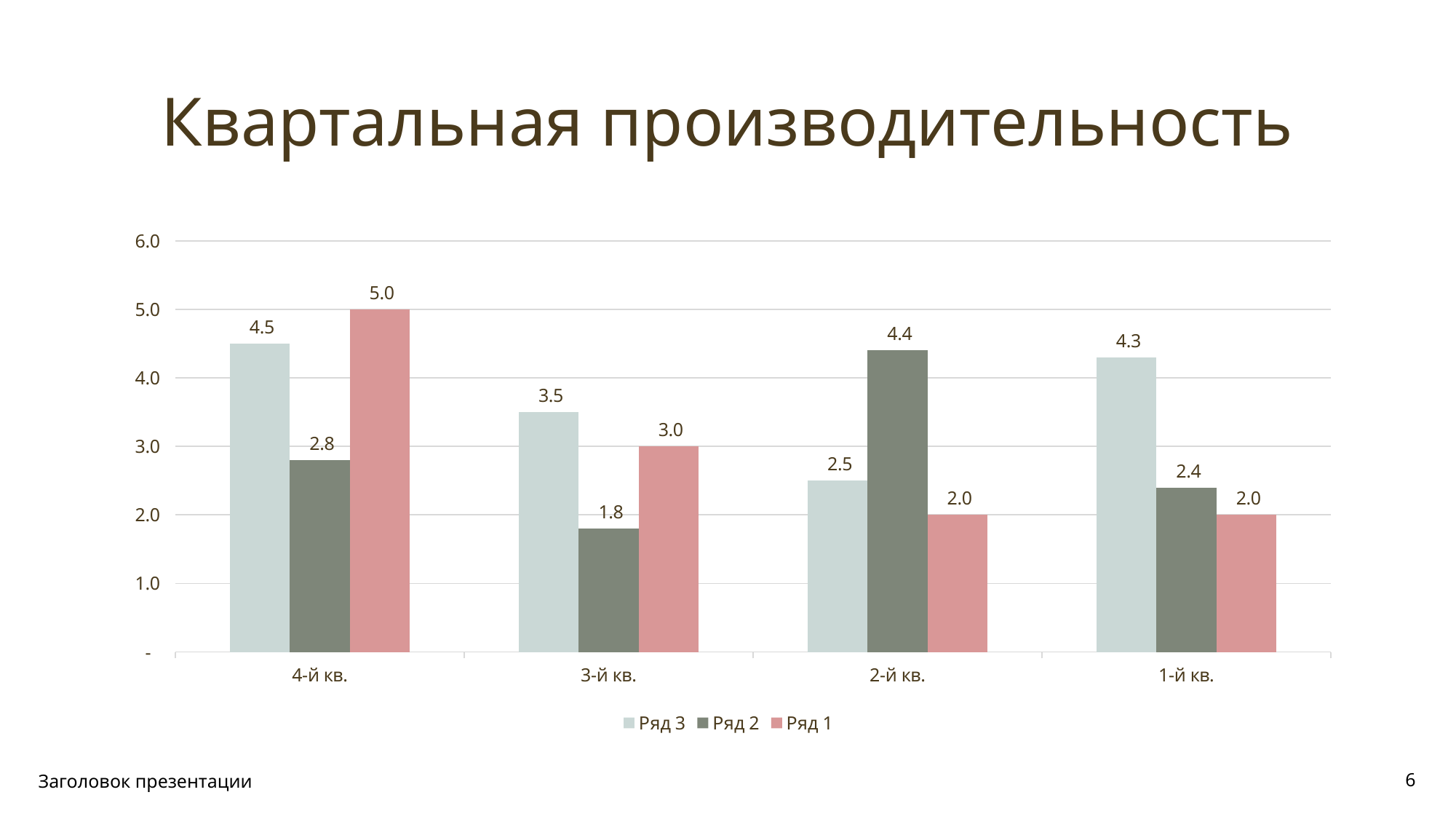
Which series is shown in pink? Ряд 1 What is the value of Ряд 1 for 4-й кв.? 5.0 Which category has the lowest value for Ряд 3? 2-й кв. What is the title of the chart? Квартальная производительность What is the value of Ряд 3 for 1-й кв.? 4.3 What kind of chart is shown on the slide? Bar chart Which is larger for 2-й кв.: Ряд 2 or Ряд 3? Ряд 2 Which category has the highest value for Ряд 2? 2-й кв. What is the difference between Ряд 1 and Ряд 2 for 4-й кв.? 2.2 How many categories are shown on the x axis? 4 How many series does the legend list? 3 What is the value of Ряд 2 for 3-й кв.? 1.8